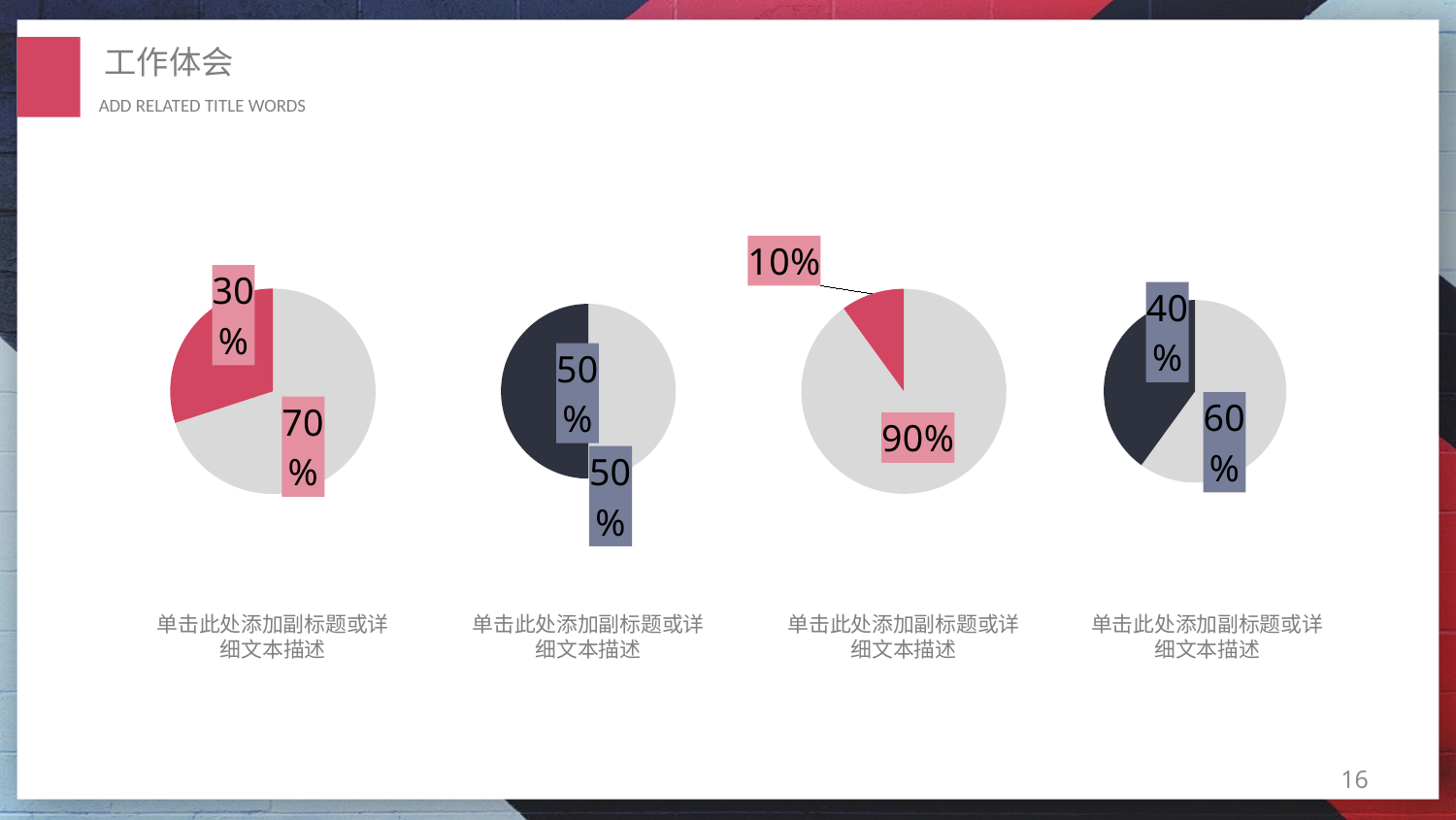
In the leftmost pie chart, what share does the grey slice represent? 70% In the rightmost pie chart, what share does the grey slice represent? 60% In the third pie chart from the left, which slice is the largest? the grey slice (90%) In the rightmost pie chart, what is the difference between the grey slice and the dark slice? 20% In the rightmost pie chart, what share does the dark slice represent? 40% How many slices does the third pie chart from the left have? 2 In the leftmost pie chart, which slice is larger, the red slice or the grey slice? the grey slice How many pie charts are shown on the slide? 4 What kind of chart is the leftmost chart on the slide? pie chart